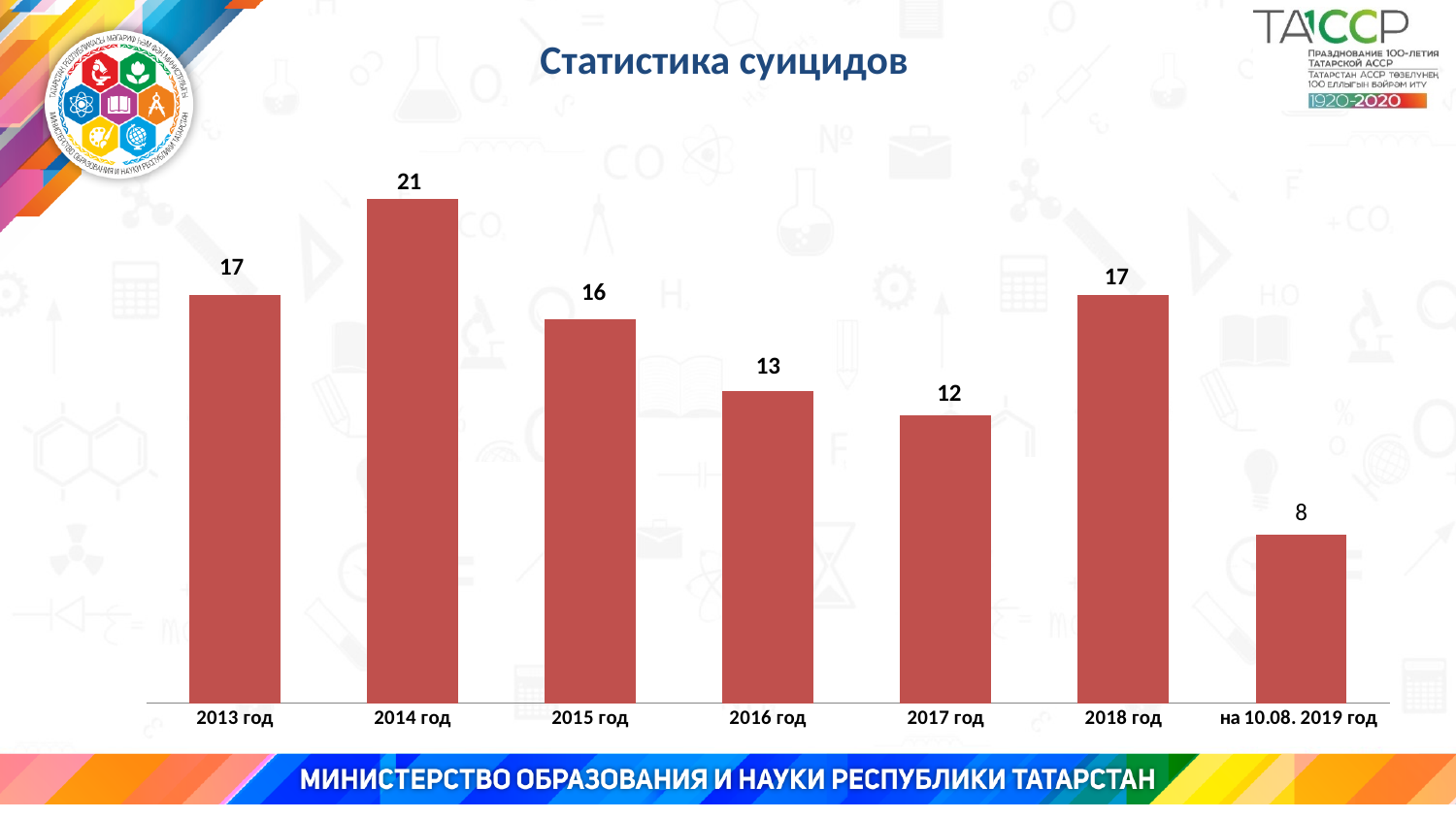
Which is larger, the value for 2015 год or the value for 2016 год? 2015 год Which category has the highest value? 2014 год What is the value for 2016 год? 13 What kind of chart is shown on the slide? bar chart How many categories are shown on the x axis? 7 What is the value for 2018 год? 17 What is the value for на 10.08. 2019 год? 8 What is the title of the chart? Статистика суицидов What is the difference between the values for 2014 год and 2017 год? 9 Which category has the lowest value? на 10.08. 2019 год Do the values rise or fall from 2014 год to 2017 год? fall What is the value for 2014 год? 21